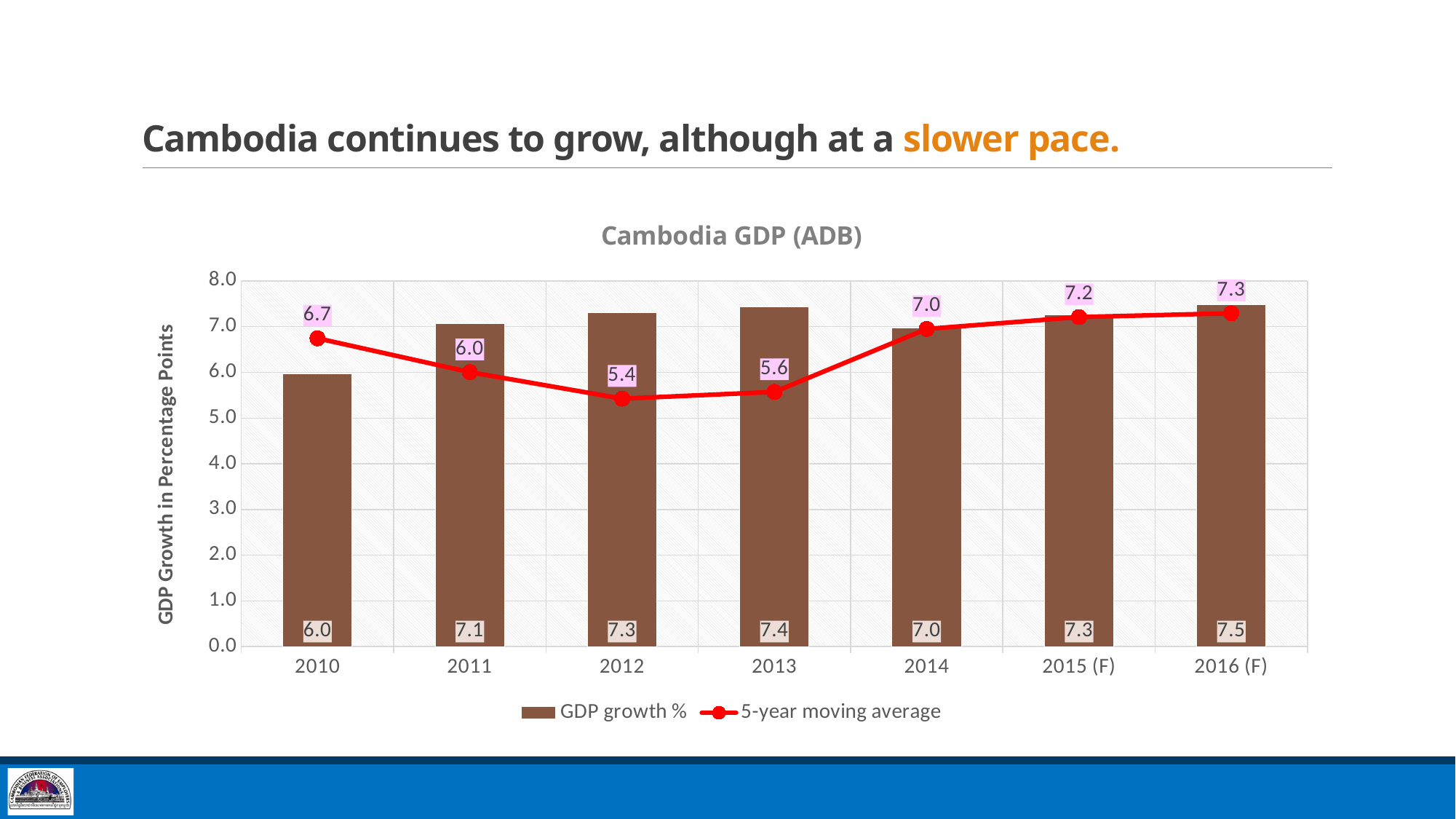
What is the difference between the GDP growth % in 2013 and in 2010? 1.4 Does the 5-year moving average rise or fall from 2012 to 2016 (F)? Rise What kind of chart is this? Combined bar and line chart What is the GDP growth % value for 2016 (F)? 7.5 Which is larger, the GDP growth % in 2011 or in 2014? 2011 Which year has the highest GDP growth %? 2016 (F) What is the 5-year moving average value for 2012? 5.4 What is the GDP growth % value for 2013? 7.4 How many series does the legend list? 2 How many years are shown on the x axis? 7 What is the title of the chart? Cambodia GDP (ADB) Which year has the lowest 5-year moving average? 2012